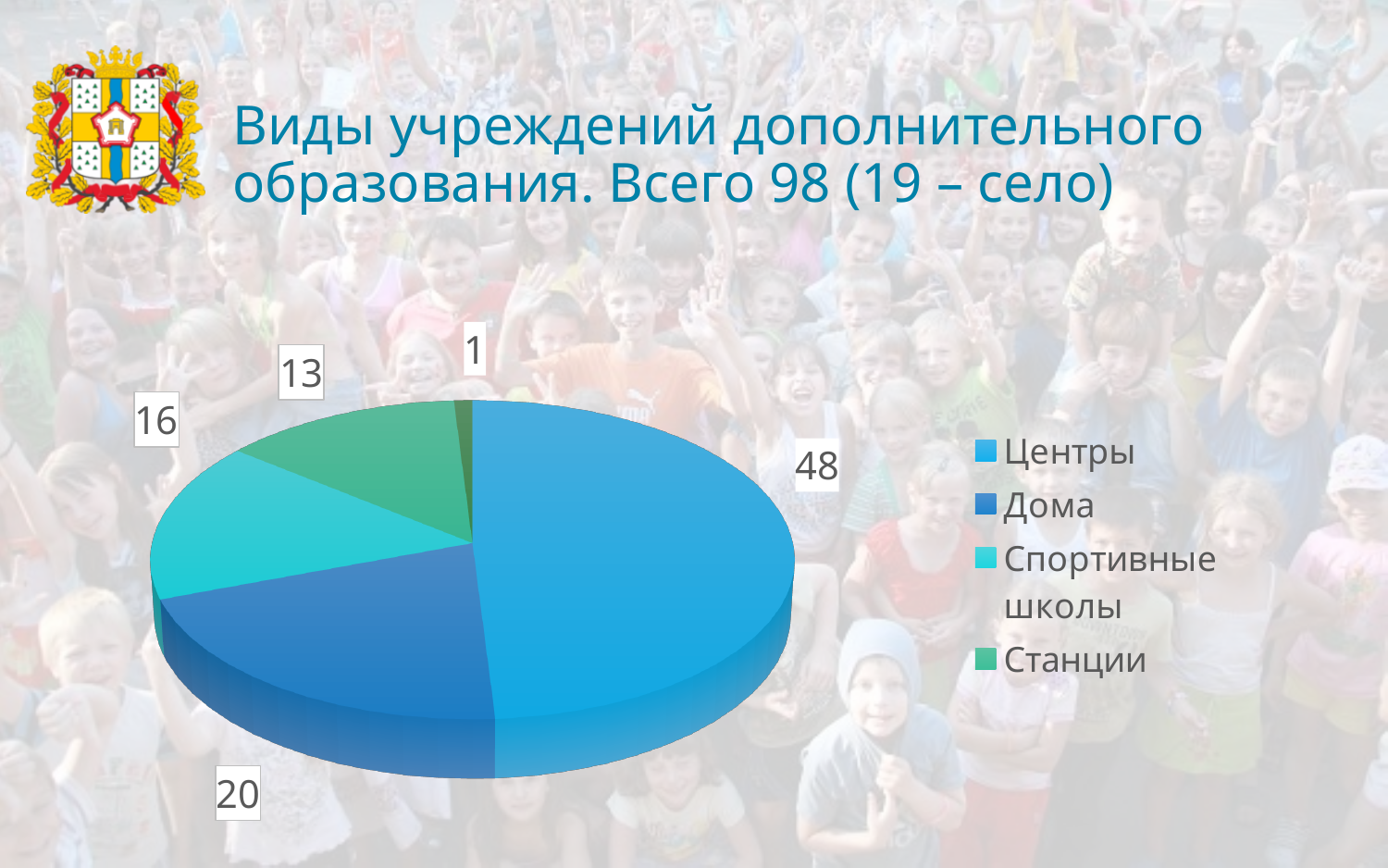
Which category has the largest slice of the pie? Центры What is the value for Спортивные школы? 16 How many slices does the pie chart have? 5 What is the value for Центры? 48 What is the value for Станции? 13 What is the smallest value labelled on the pie chart? 1 What total number of institutions does the slide title state? 98 What kind of chart is shown on the slide? pie chart What is the difference between the values for Центры and Дома? 28 Which is larger, the value for Спортивные школы or the value for Станции? Спортивные школы What is the value for Дома? 20 How many entries does the legend list? 4